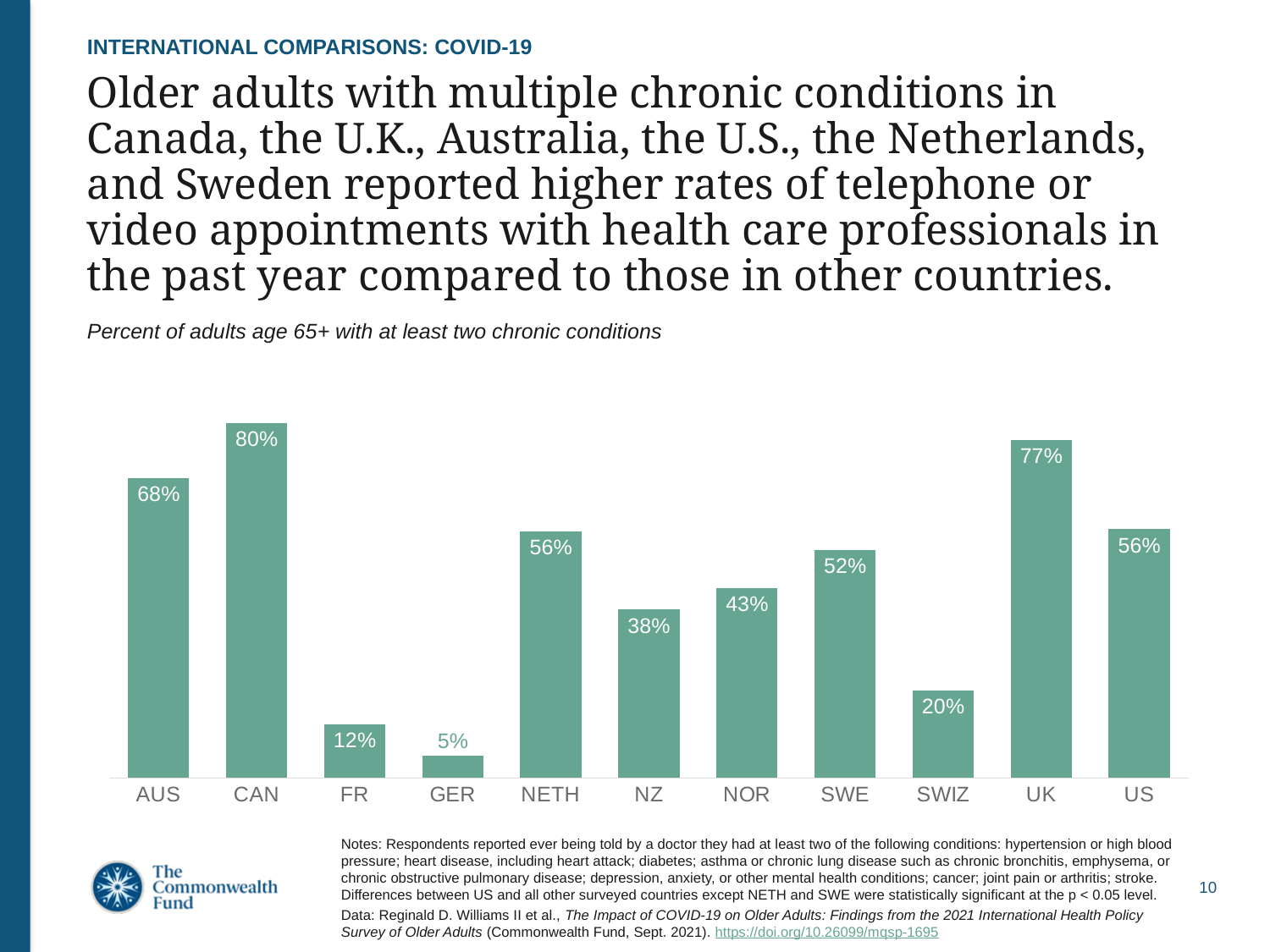
What is the difference between the values for UK and US? 21% Which is larger, the value for AUS or the value for UK? UK Which country has the lowest value? GER Which is larger, the value for NZ or the value for SWE? SWE Which country has the highest value? CAN How many countries are shown in the chart? 11 What kind of chart is shown on the slide? Bar chart What is the value for CAN? 80% What is the value for SWIZ? 20% What is the difference between the values for AUS and FR? 56% What does the chart's subtitle say is being measured? Percent of adults age 65+ with at least two chronic conditions What is the value for NOR? 43%